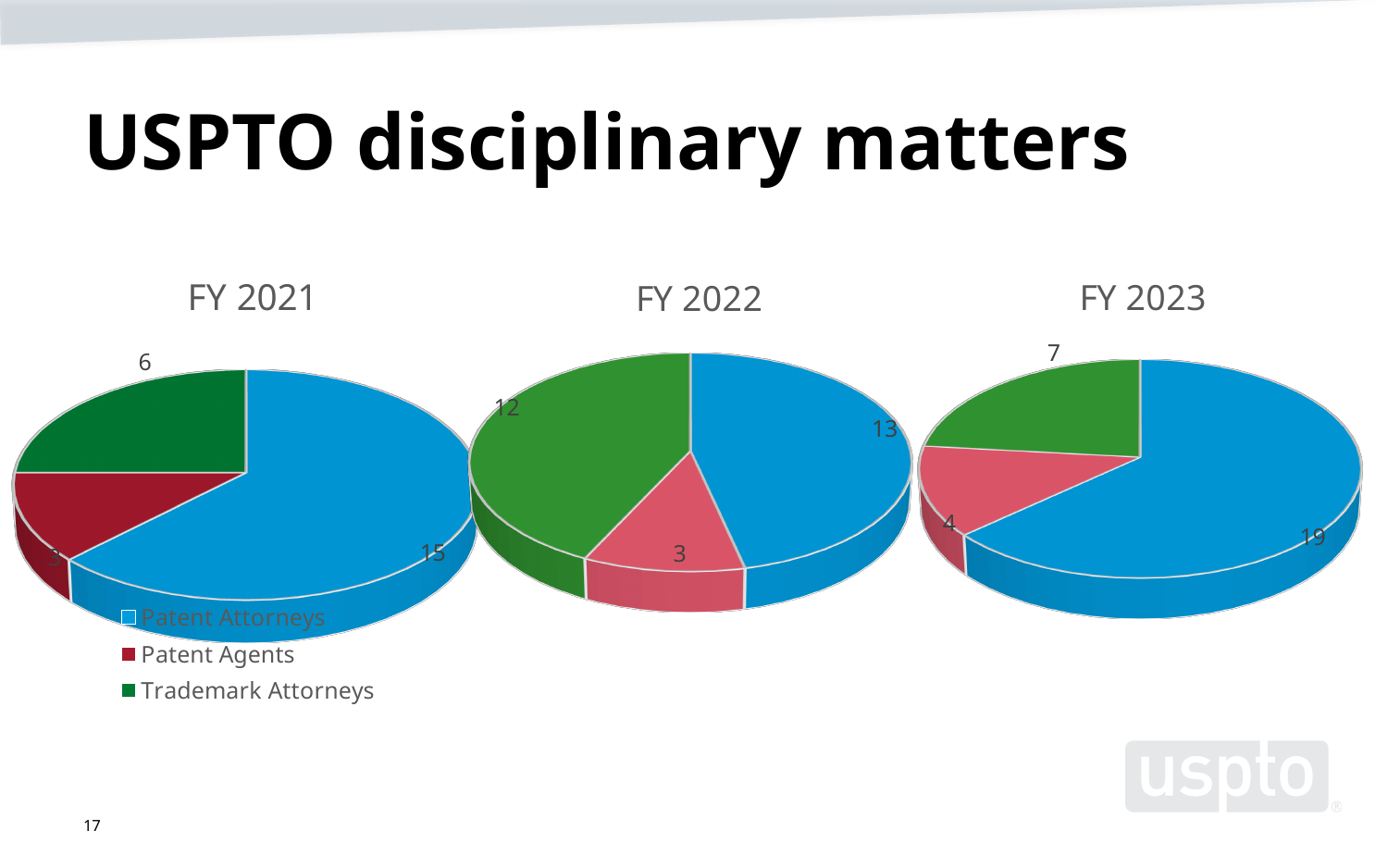
In the FY 2021 chart, what is the total of all three slices? 24 How many entries does the legend list? 3 In the FY 2022 chart, which category has the smallest slice? Patent Agents In the FY 2021 chart, what is the value for Patent Attorneys? 15 In the FY 2023 chart, what is the difference between the Patent Attorneys value and the Trademark Attorneys value? 12 In the FY 2023 chart, which category has the largest slice? Patent Attorneys What kind of chart is the FY 2022 chart? Pie chart In the FY 2022 chart, which is larger, Patent Attorneys or Trademark Attorneys? Patent Attorneys In the FY 2023 chart, what is the value for Patent Agents? 4 How many slices does the FY 2021 chart have? 3 In the FY 2021 chart, what share of the total do Patent Agents represent? 12.5% In the FY 2022 chart, what is the value for Trademark Attorneys? 12